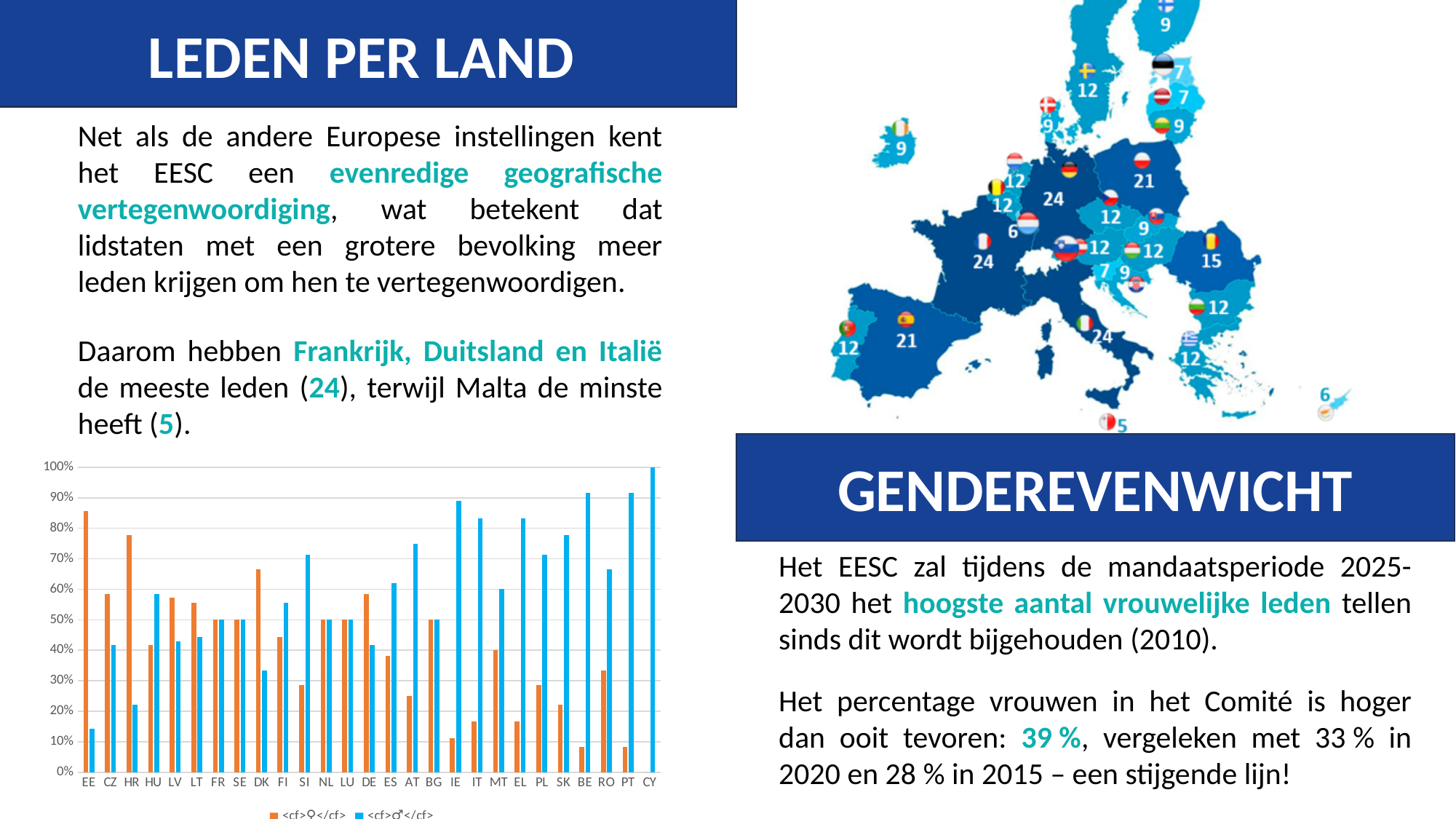
In the bar chart, is the value of the orange bar for EE greater or less than 80%? greater What kind of chart is shown at the bottom left of the slide? bar chart In the bar chart, which country has the highest blue bar? CY In the bar chart, which bar is larger for HR, the orange one or the blue one? orange In the bar chart, what is the value of the blue bar for CY? 100% In the bar chart, which bar is larger for MT, the orange one or the blue one? blue In the bar chart, is the value of the blue bar for EE greater or less than 20%? less How many countries (categories) are shown on the x axis of the bar chart? 27 How many series does the legend of the bar chart list? 2 In the bar chart, what is the value of the orange bar for FR? 50% In the bar chart, is the value of the blue bar for IE greater or less than 80%? greater In the bar chart, which country has the lowest blue bar? EE